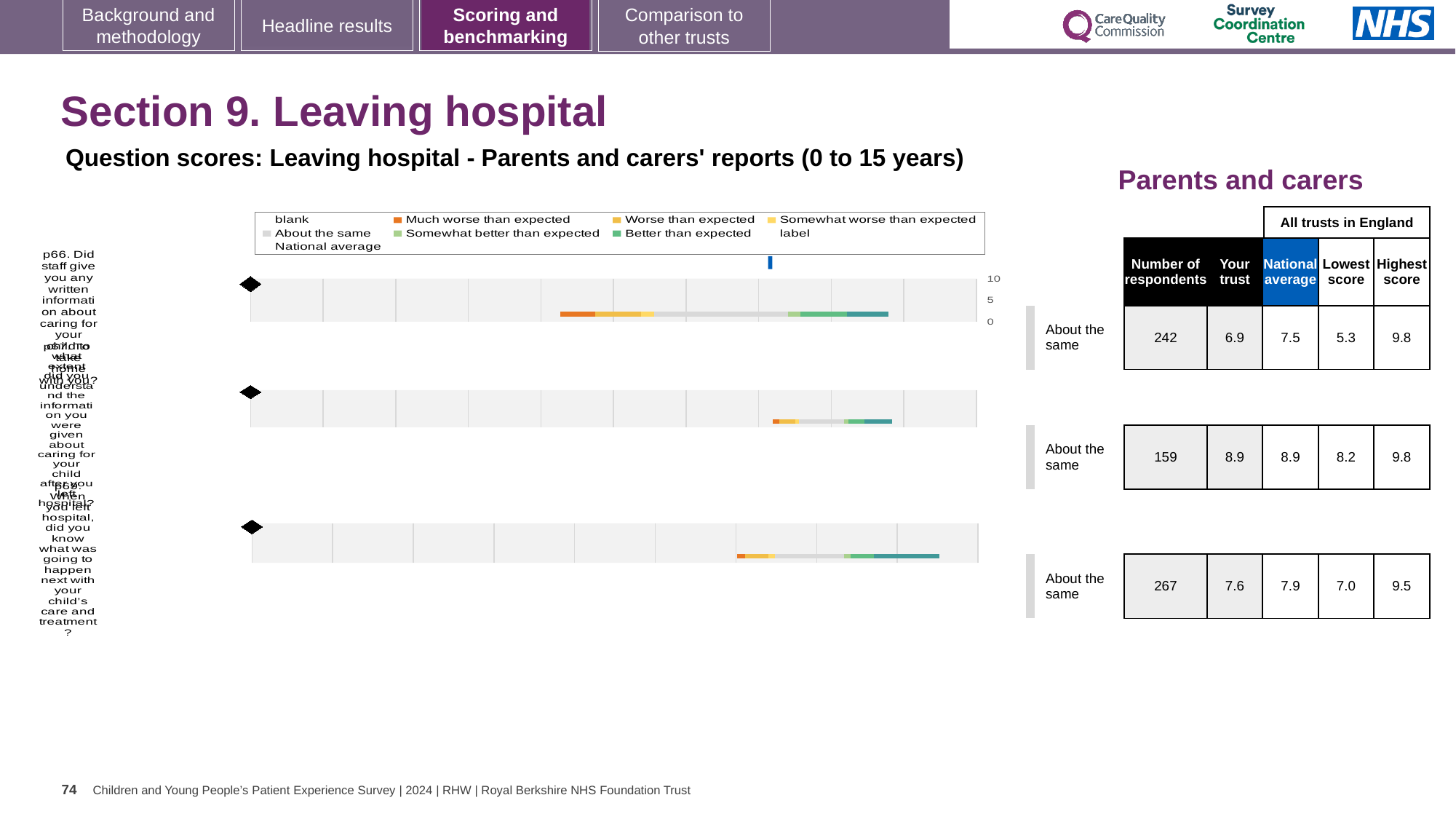
For the top chart row, is the 'Your trust' score (6.9) larger or smaller than the National average (7.5)? smaller Which legend entry is shown in dark teal in the chart legend? Better than expected In the table beside the top chart, what is the 'Your trust' score? 6.9 How many question-score bar charts are shown on the slide? 3 Which of the three chart rows has the highest 'Your trust' score in the table? the middle row (8.9) In the table beside the top chart, what is the National average score? 7.5 In the table beside the bottom chart, what is the Highest score? 9.5 What kind of chart is used for the three question-score rows on the slide? bar chart For the bottom chart row, what is the difference between the National average (7.9) and Your trust (7.6) scores? 0.3 In the table beside the middle chart, how many respondents are listed? 159 Which of the three chart rows has the lowest 'Lowest score' in the table? the top row (5.3) Which legend entry is shown in orange in the chart legend? Much worse than expected